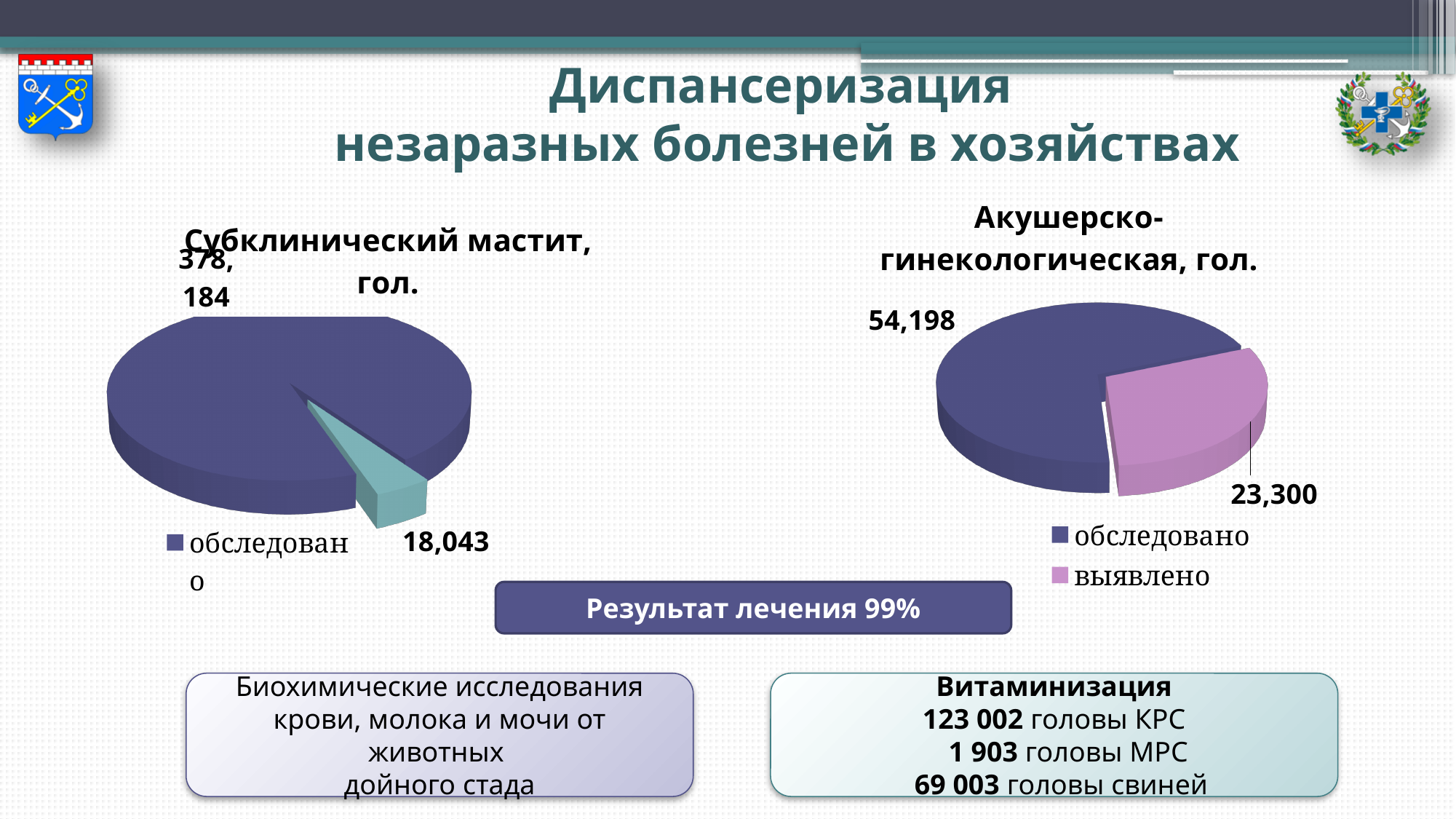
In the left chart "Субклинический мастит, гол.", what is the value for "обследовано"? 378,184 What is the title of the right pie chart? Акушерско-гинекологическая, гол. In the right chart "Акушерско-гинекологическая, гол.", what is the value for "обследовано"? 54,198 In the right chart "Акушерско-гинекологическая, гол.", what is the value for "выявлено"? 23,300 How many slices does the left chart "Субклинический мастит, гол." have? 2 What kind of chart is the left chart titled "Субклинический мастит, гол."? pie chart How many entries does the legend of the right chart "Акушерско-гинекологическая, гол." list? 2 In the left chart "Субклинический мастит, гол.", what value is labelled on the small teal slice? 18,043 In the right chart "Акушерско-гинекологическая, гол.", what is the total of the two slices? 77,498 In the right chart "Акушерско-гинекологическая, гол.", which is larger: "обследовано" or "выявлено"? обследовано In the left chart "Субклинический мастит, гол.", what is the difference between the large slice (378,184) and the small teal slice (18,043)? 360,141 In the right chart "Акушерско-гинекологическая, гол.", what is the difference between "обследовано" and "выявлено"? 30,898